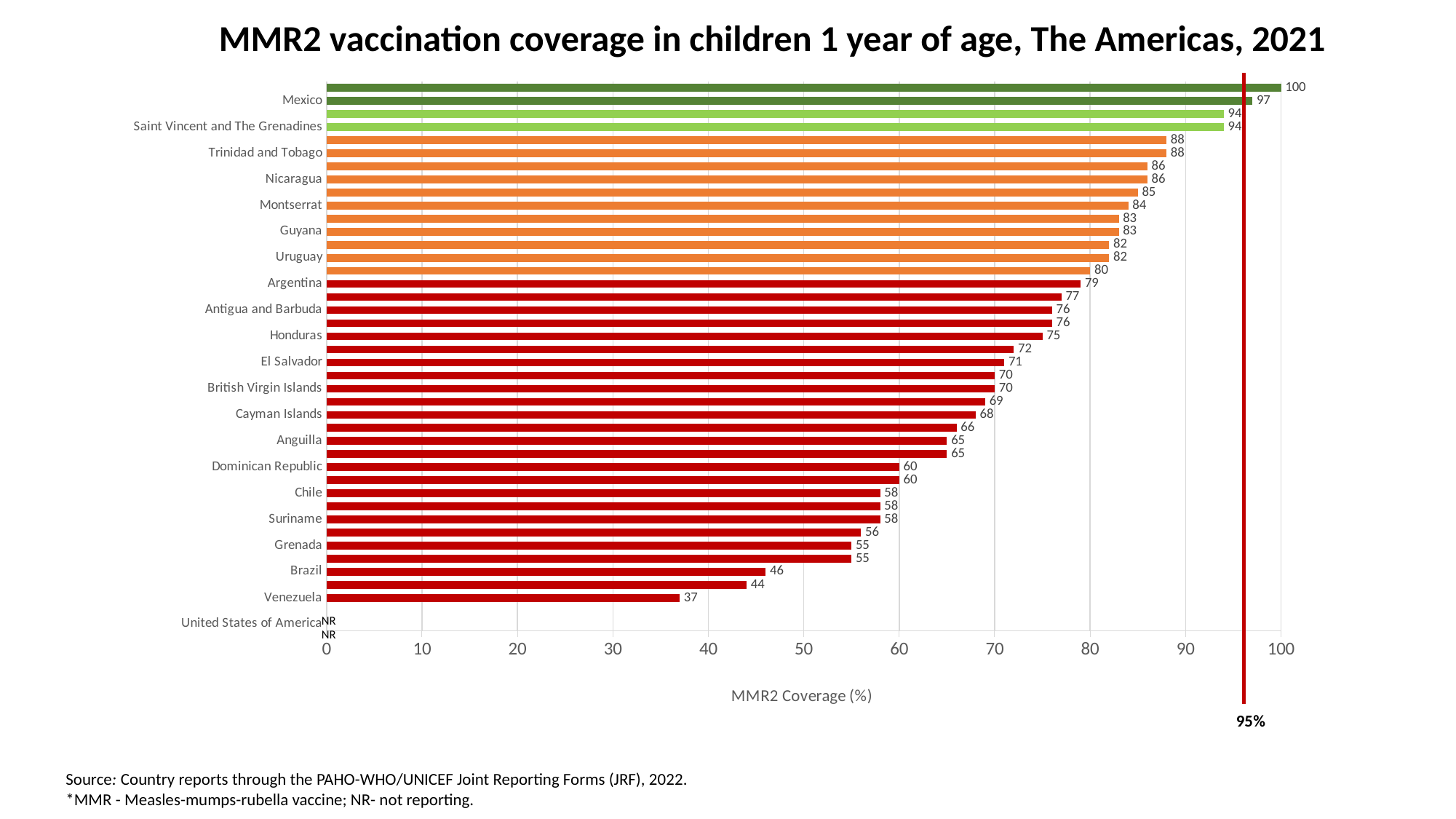
Which has higher MMR2 coverage, Nicaragua or Honduras? Nicaragua What is the MMR2 coverage value for Venezuela? 37 What value does the vertical red reference line mark? 95% What is the MMR2 coverage value for Mexico? 97 What is the MMR2 coverage value for Saint Vincent and The Grenadines? 94 What is the MMR2 coverage value for Brazil? 46 What is the label of the x axis? MMR2 Coverage (%) Is the value for Argentina greater or less than 80? less What is the value of the longest bar on the chart? 100 What value is shown for the United States of America? NR What kind of chart is shown on the slide? Bar chart What is the difference in MMR2 coverage between Mexico and Venezuela? 60